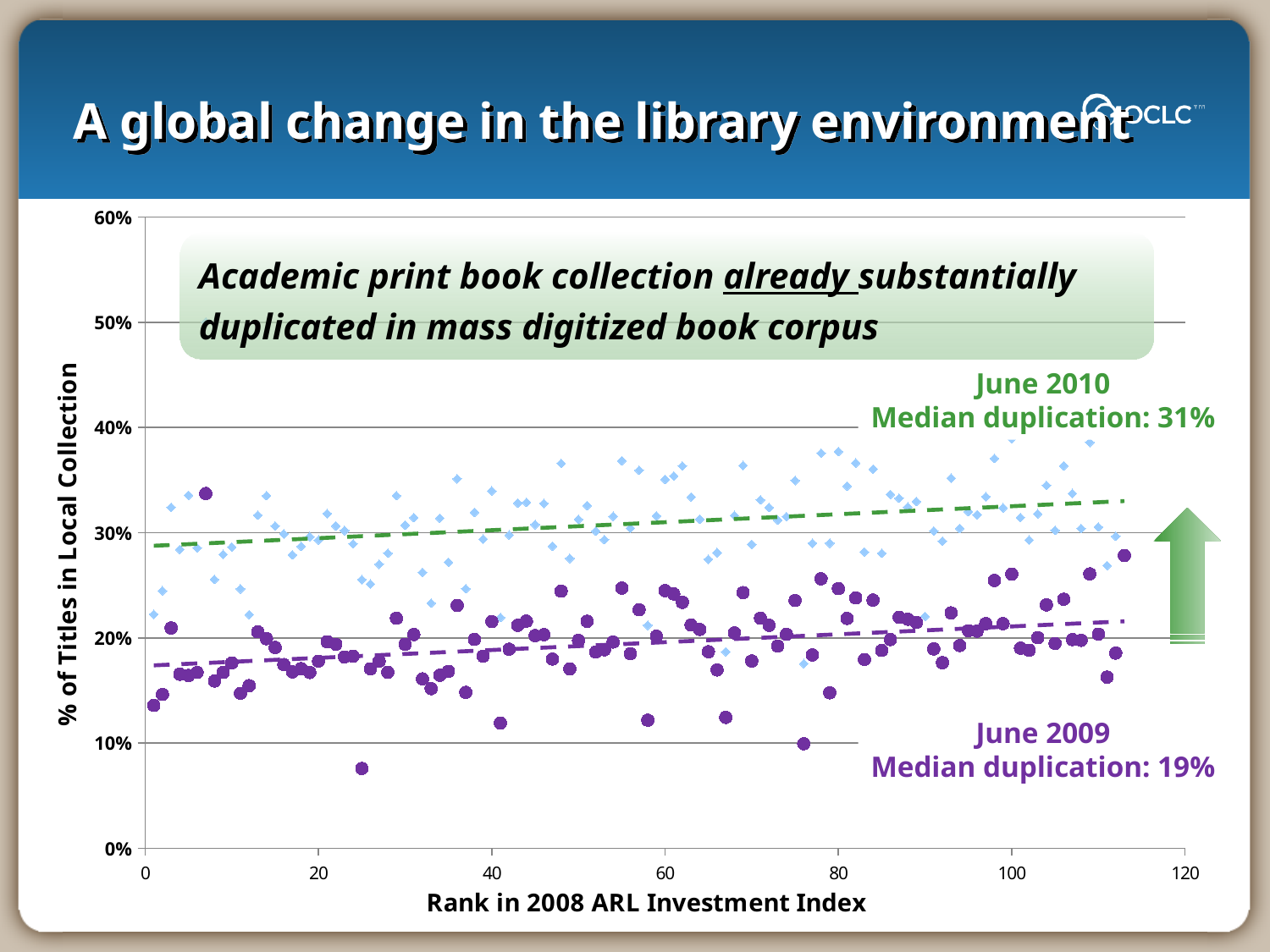
What is the difference between the June 2010 and June 2009 median duplication values? 12 percentage points What is the median duplication for June 2010? 31% What is the label of the y axis? % of Titles in Local Collection What is the median duplication for June 2009? 19% How many data series are plotted on the chart? 2 What is the highest value shown on the y axis? 60% What is the label of the x axis? Rank in 2008 ARL Investment Index Is the June 2009 median duplication greater or less than 20%? less Is the June 2010 median duplication greater or less than 30%? greater Which series has the higher median duplication, June 2010 or June 2009? June 2010 Do the dashed trend lines for both series rise or fall as rank increases along the x axis? Rise What kind of chart is shown on the slide? Scatter chart